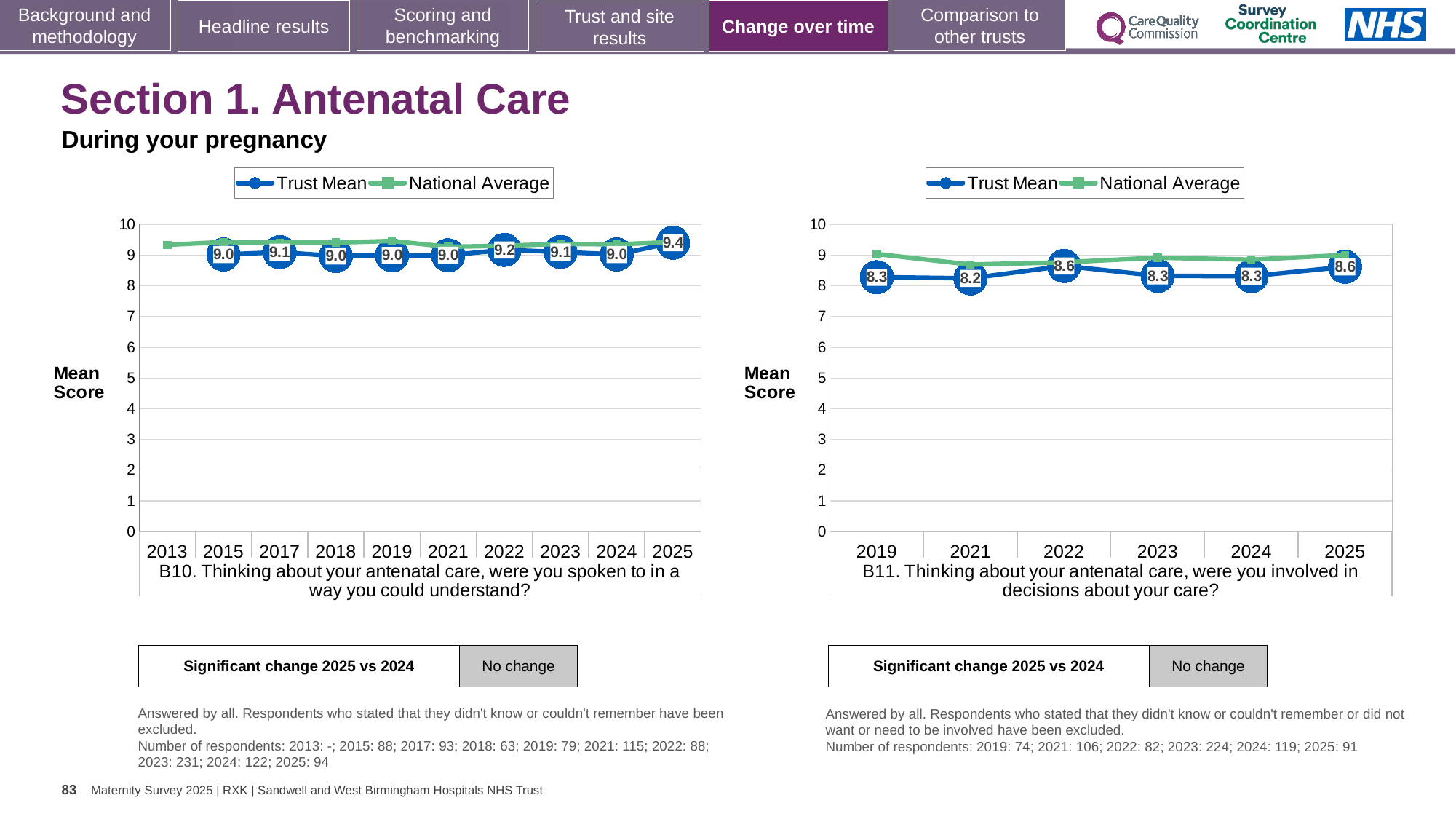
In the B11 chart, what is the Trust Mean for 2023? 8.3 What type of chart is the B11 chart? line chart In the B10 chart, what is the Trust Mean for 2025? 9.4 In the B10 chart, how many years are shown on the x axis? 10 In the B11 chart, is the Trust Mean for 2022 larger or smaller than the Trust Mean for 2021? larger In the B11 chart, is the National Average for 2019 greater or less than 8? greater In the B10 chart, what is the difference between the Trust Mean in 2025 and in 2024? 0.4 In the B11 chart, what is the Trust Mean for 2021? 8.2 In the B11 chart, which year has the lowest Trust Mean? 2021 In the B10 chart, how many series does the legend list? 2 In the B10 chart, what is the Trust Mean for 2022? 9.2 In the B10 chart, which year has the highest Trust Mean? 2025